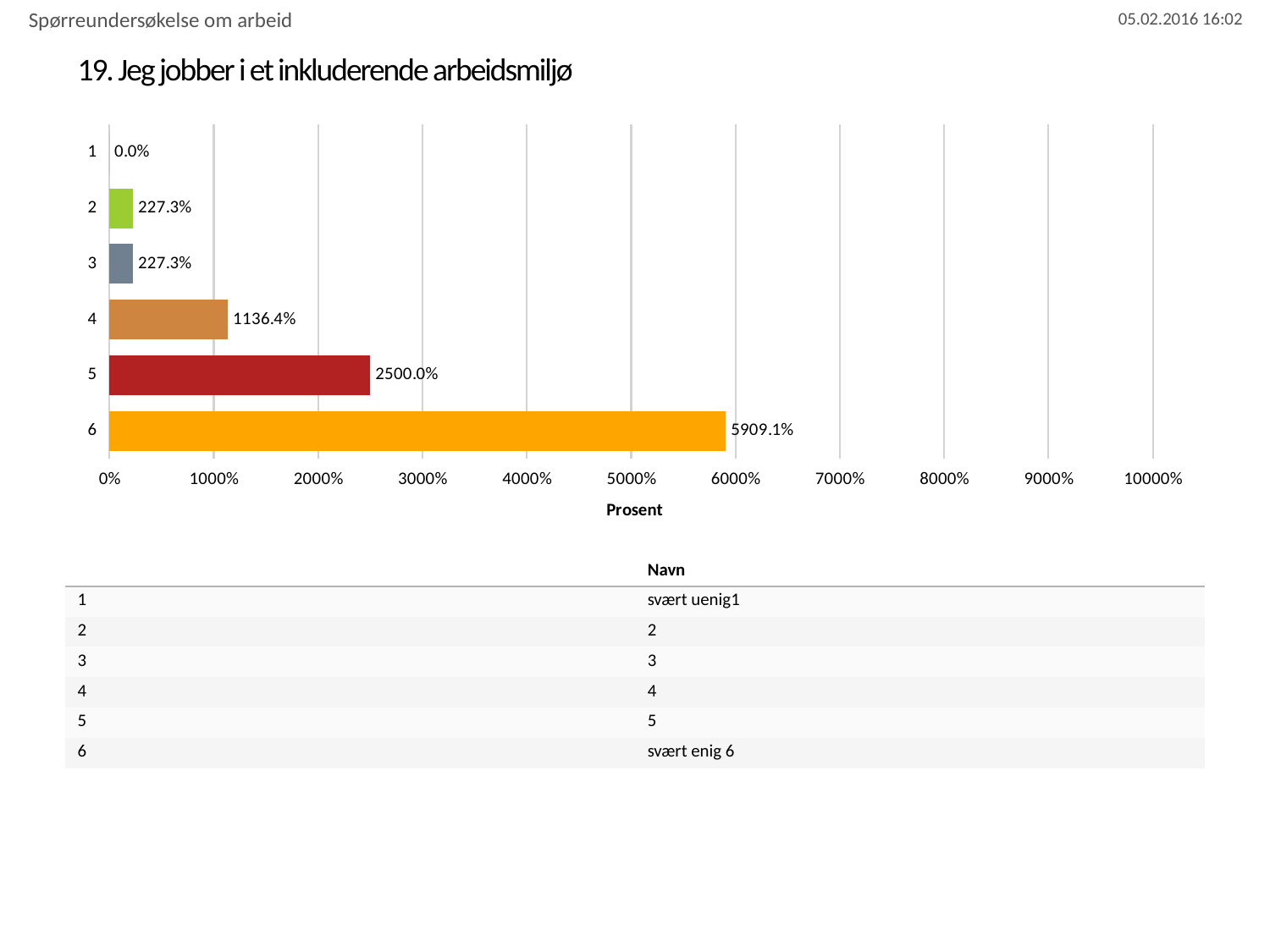
Which category has the lowest value? 1 What kind of chart is shown on the slide? bar chart What is the difference between the values for category 5 and category 4? 1363.6% What is the difference between the values for category 6 and category 5? 3409.1% What is the value for category 5? 2500.0% What is the value for category 4? 1136.4% Which is larger, the value for category 4 or the value for category 3? category 4 Is the value for category 6 greater or less than 5000%? greater What is the value for category 6? 5909.1% Which category has the highest value? 6 How many categories are shown in the chart? 6 What is the value for category 1? 0.0%